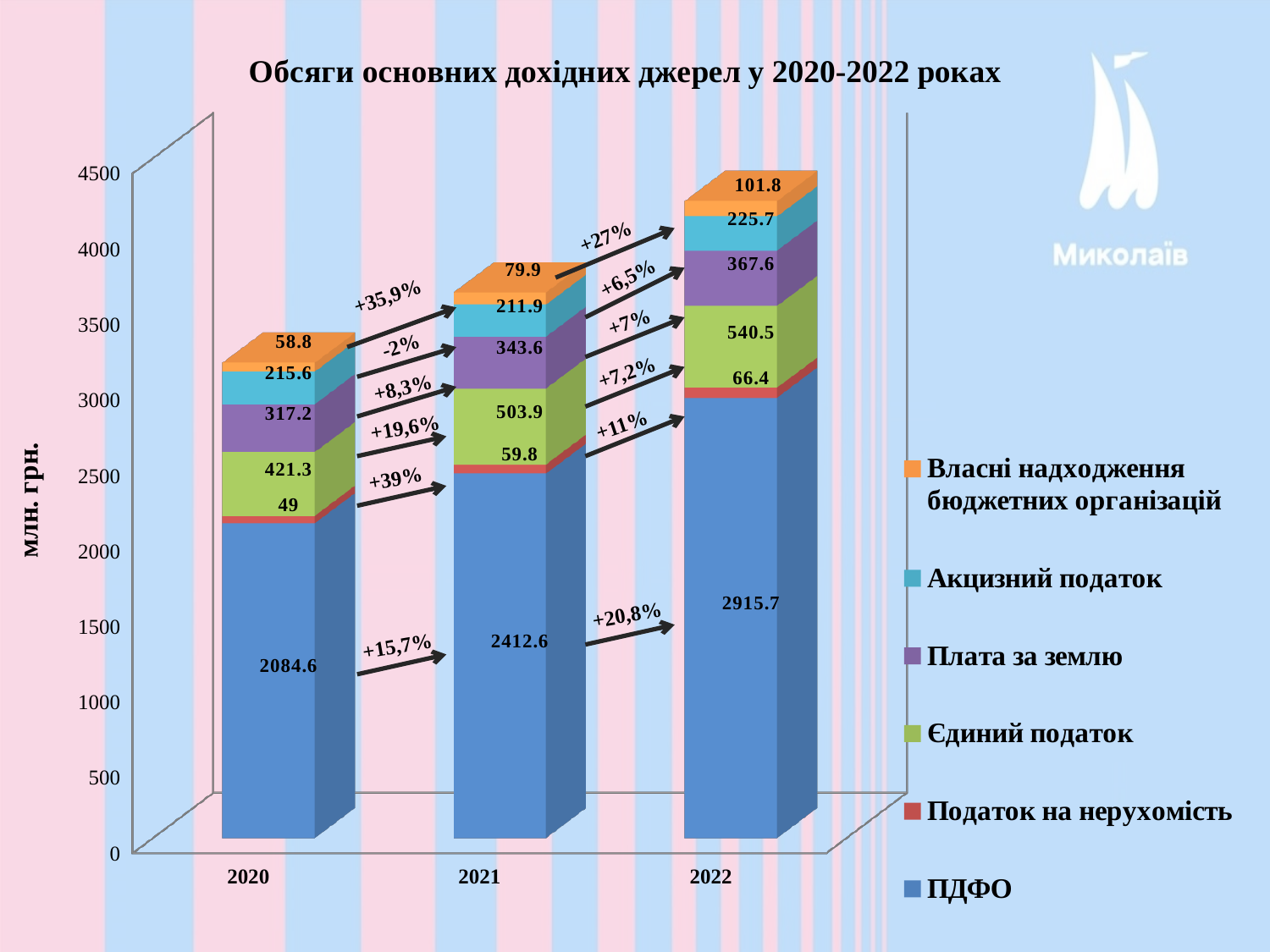
What is the value of ПДФО for 2022? 2915.7 What is the total of the stacked bar for 2020? 3146.5 Which is larger: Плата за землю in 2022 or Плата за землю in 2021? Плата за землю in 2022 What is the value of Єдиний податок for 2020? 421.3 How many series does the legend list? 6 What is the value of Акцизний податок for 2021? 211.9 How many years are shown on the x axis? 3 What is the difference between the ПДФО values for 2021 and 2020? 328 Do the values of Єдиний податок rise or fall from 2020 to 2022? Rise What kind of chart is shown on the slide? Stacked bar chart In which year is the value of Податок на нерухомість the lowest? 2020 In which year is the value of ПДФО the highest? 2022